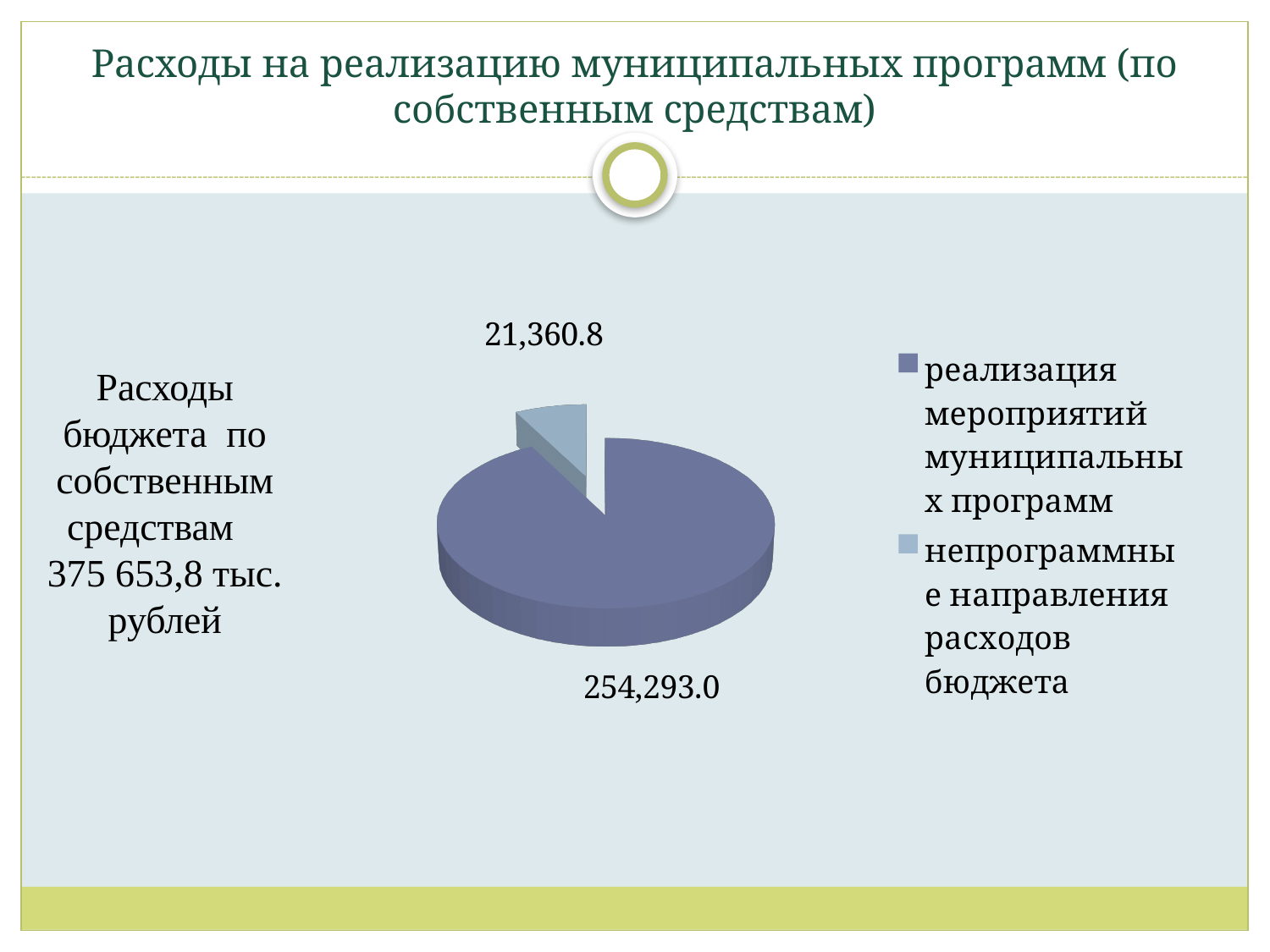
What kind of chart is shown on the slide? pie chart What is the sum of the two values shown on the pie chart? 275,653.8 Which category has the smallest slice of the pie? непрограммные направления расходов бюджета Which is larger: the value for "реализация мероприятий муниципальных программ" or the value for "непрограммные направления расходов бюджета"? реализация мероприятий муниципальных программ What is the title of the slide containing the chart? Расходы на реализацию муниципальных программ (по собственным средствам) How many slices does the pie chart have? 2 What is the value for "непрограммные направления расходов бюджета"? 21,360.8 What is the value for "реализация мероприятий муниципальных программ"? 254,293.0 How many entries does the legend list? 2 Which category has the largest slice of the pie? реализация мероприятий муниципальных программ What is the difference between the values for "реализация мероприятий муниципальных программ" and "непрограммные направления расходов бюджета"? 232,932.2 What colour is the slice for "непрограммные направления расходов бюджета"? light blue